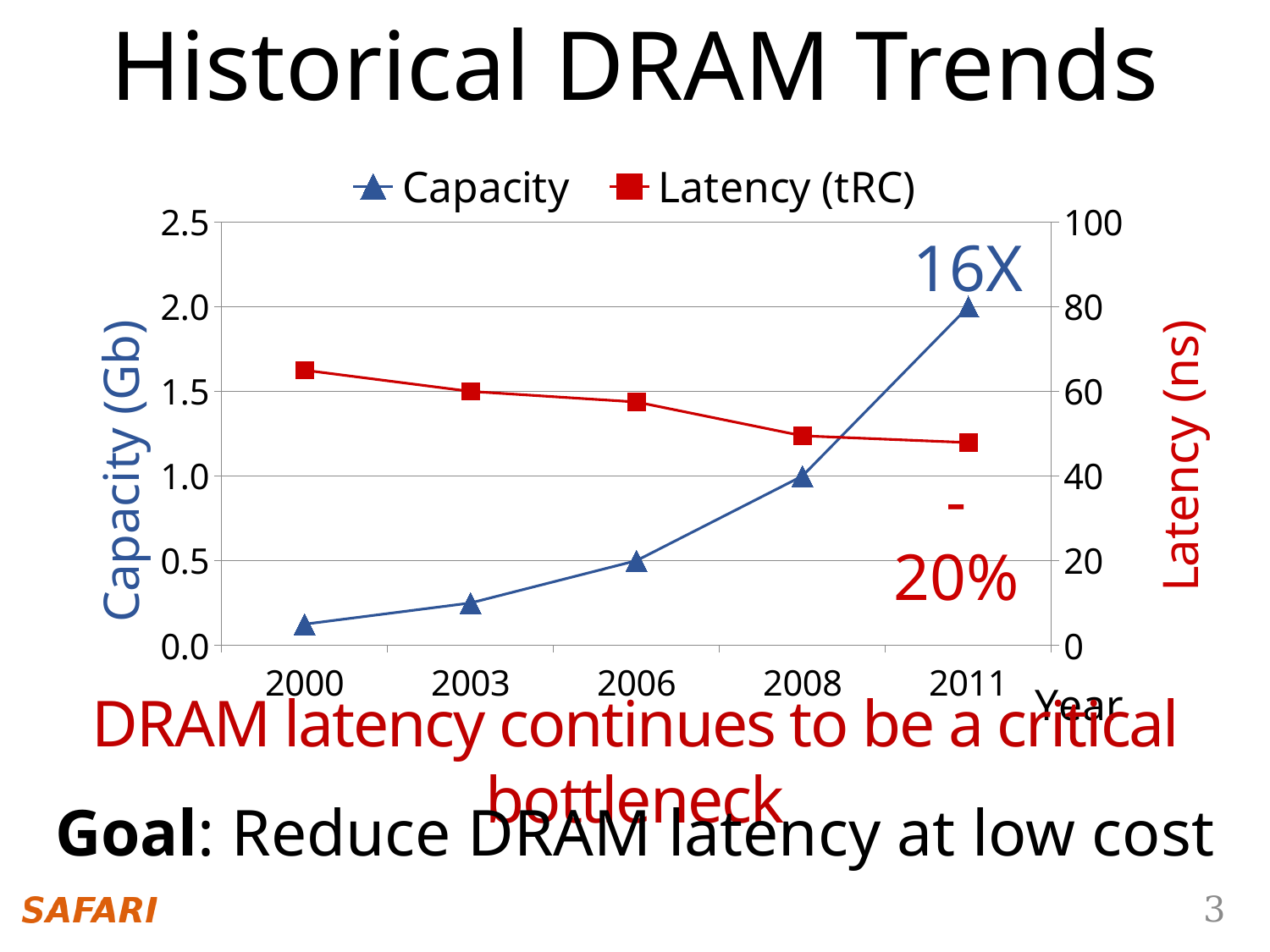
In which year is Capacity highest? 2011 Is the Latency (tRC) value in 2000 greater or less than 60? greater What is the Capacity value in 2008? 1.0 How many series does the legend list? 2 Is the Latency (tRC) value in 2011 greater or less than 60? less Does the Capacity series rise or fall from 2000 to 2011? rise In which year is Latency (tRC) highest? 2000 What is the Capacity value in 2011? 2.0 How many years are plotted along the x axis? 5 Does the Latency (tRC) series rise or fall from 2000 to 2011? fall What kind of chart is shown on the slide? line chart What annotation is printed next to the Capacity series at 2011? 16X